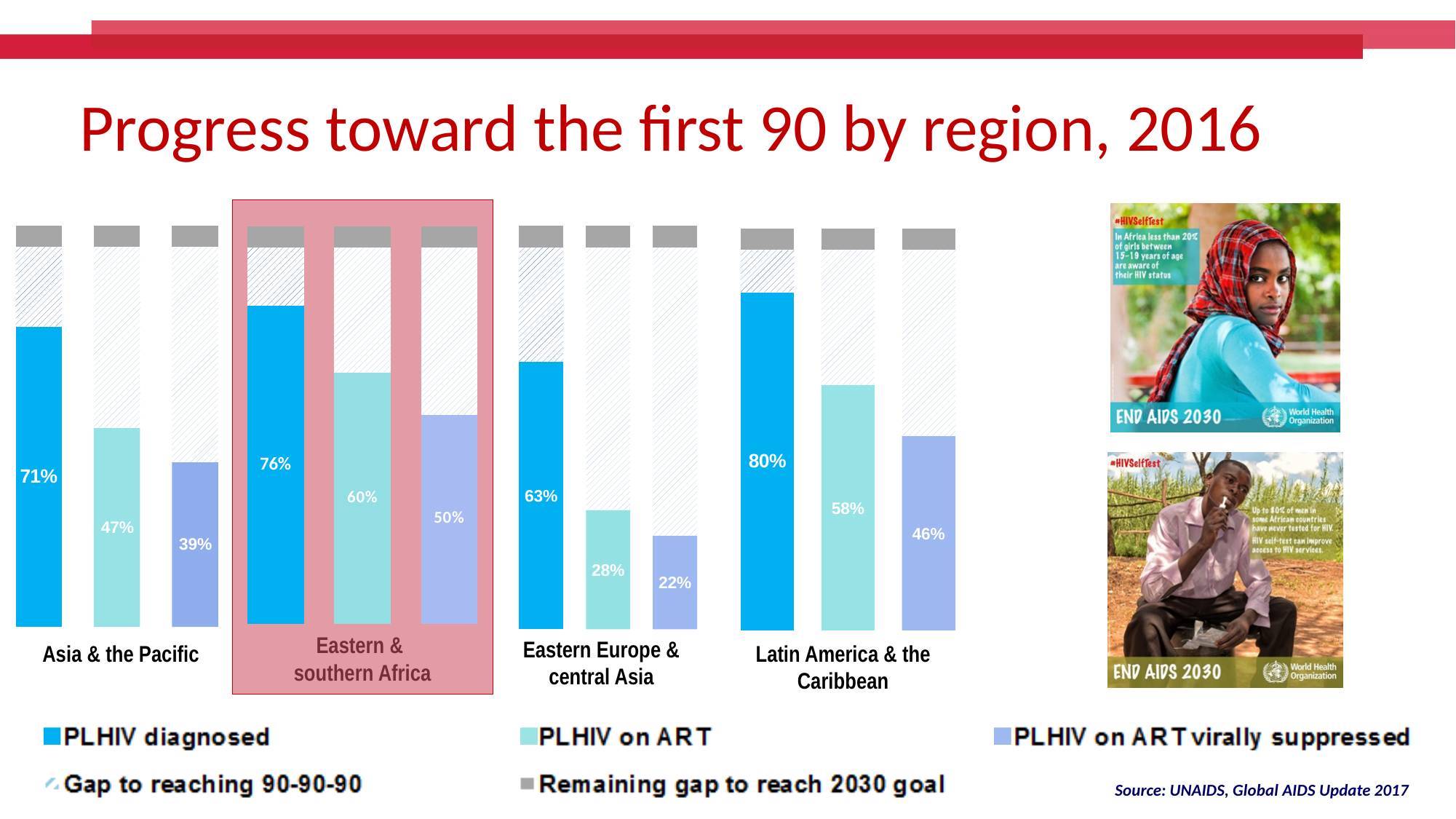
Which region has the highest percentage of PLHIV diagnosed? Latin America & the Caribbean What kind of chart is shown on the slide? Bar chart What is the title of the slide? Progress toward the first 90 by region, 2016 Which is larger: PLHIV on ART in Asia & the Pacific or PLHIV on ART in Latin America & the Caribbean? Latin America & the Caribbean Which region is highlighted with a pink box on the chart? Eastern & southern Africa What is the difference between PLHIV diagnosed and PLHIV on ART in Latin America & the Caribbean? 22% What is the value for PLHIV on ART virally suppressed in Eastern & southern Africa? 50% How many regions are shown on the chart? 4 How many entries does the legend list? 5 What is the value for PLHIV on ART in Eastern Europe & central Asia? 28% What percentage of PLHIV are diagnosed in Asia & the Pacific? 71% Which region has the lowest percentage of PLHIV on ART virally suppressed? Eastern Europe & central Asia